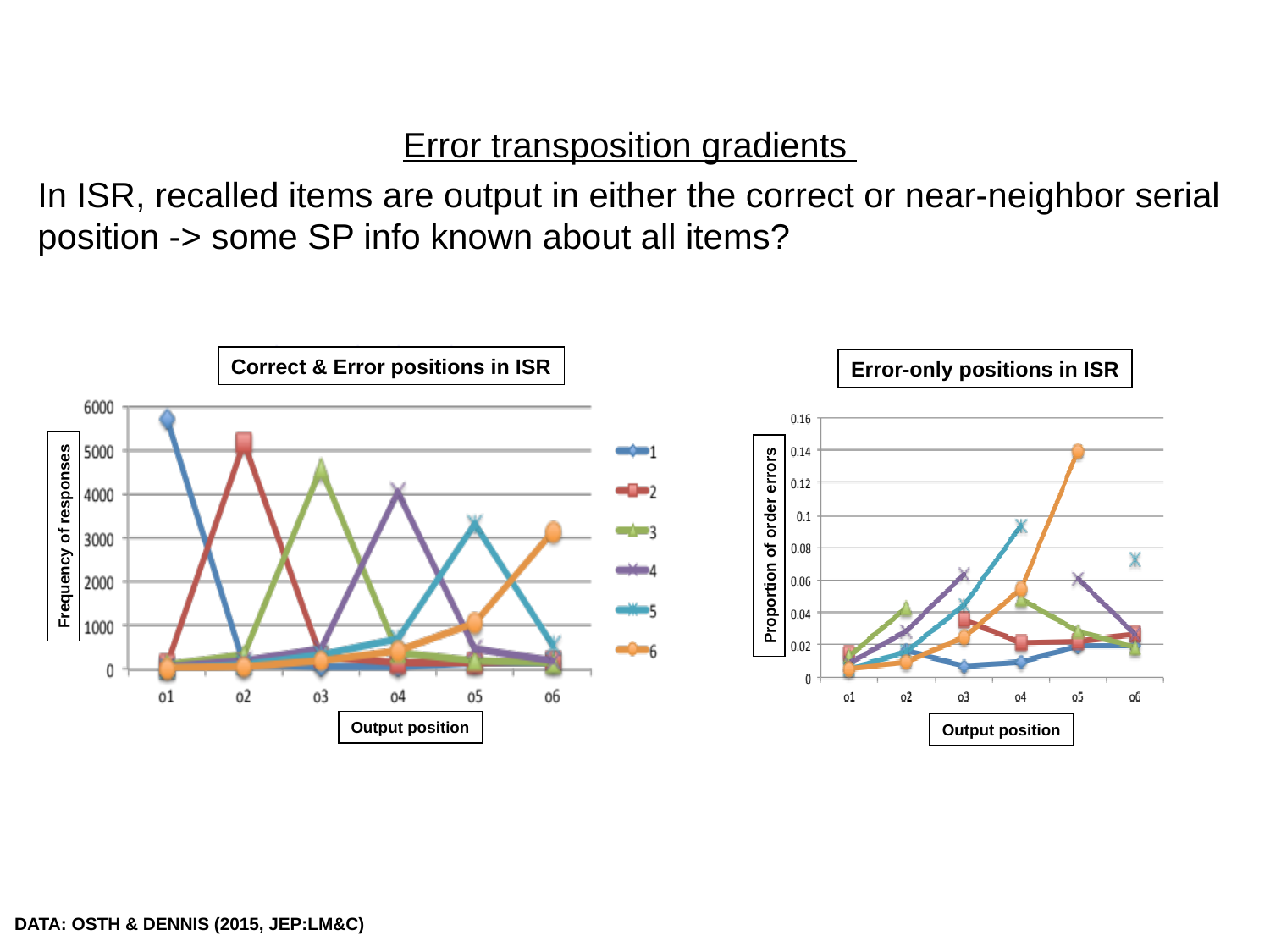
In the 'Error-only positions in ISR' chart, is the highest plotted value greater or less than 0.12? greater What is the y-axis title of the 'Correct & Error positions in ISR' chart? Frequency of responses What kind of chart is the 'Correct & Error positions in ISR' chart? line chart In the 'Correct & Error positions in ISR' chart, is the value for series 3 at o3 greater or less than 4000? greater In the 'Correct & Error positions in ISR' chart, at output position o1, which is larger: series 1 or series 2? series 1 In the 'Correct & Error positions in ISR' chart, at which output position does series 1 reach its highest value? o1 In the 'Correct & Error positions in ISR' chart, is the value for series 5 at o5 greater or less than 3000? greater What is the y-axis title of the 'Error-only positions in ISR' chart? Proportion of order errors How many series does the legend of the 'Correct & Error positions in ISR' chart list? 6 How many output positions are shown on the x axis of the 'Correct & Error positions in ISR' chart? 6